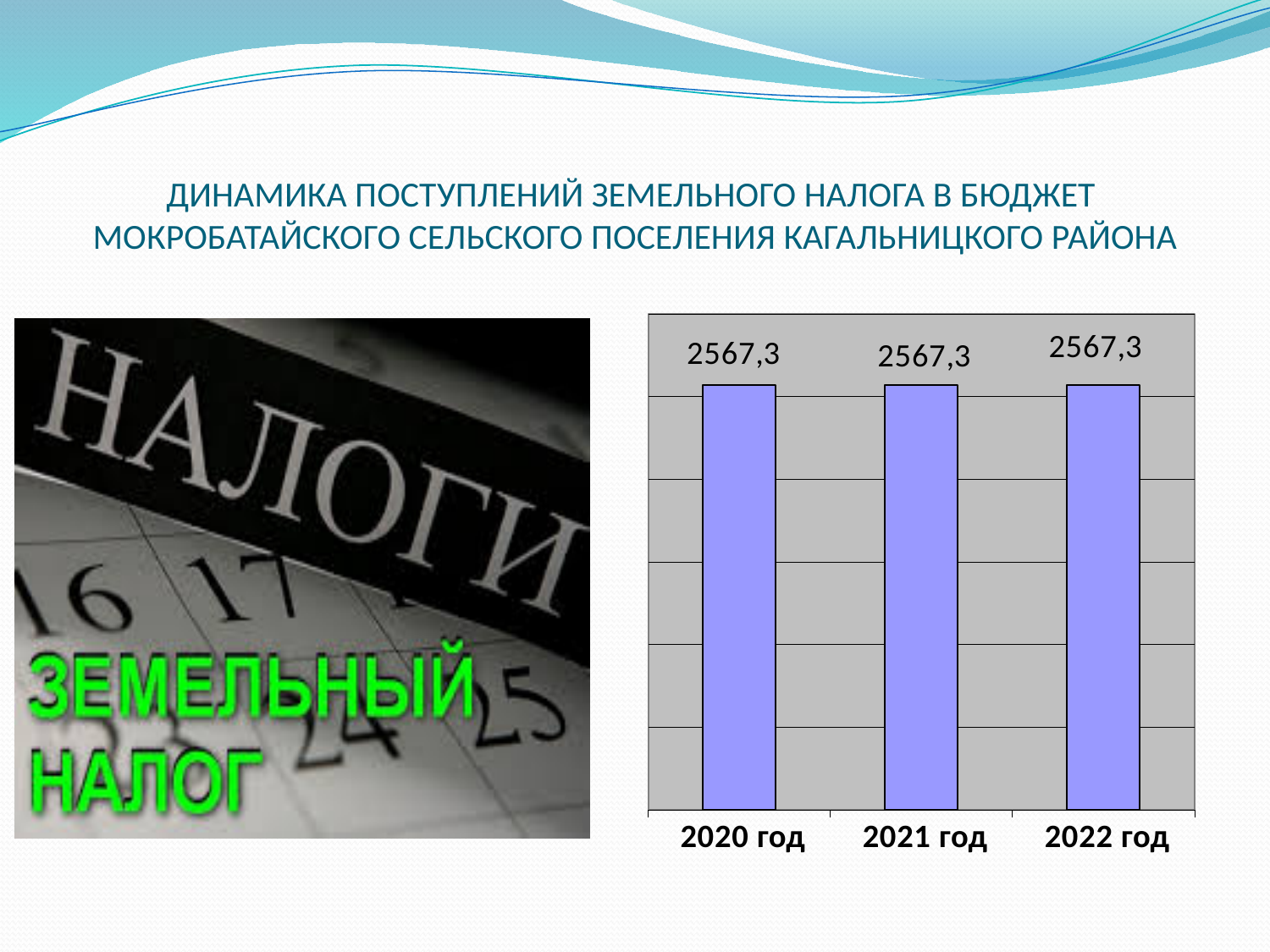
What kind of chart is shown on the slide? Bar chart What colour are the bars in the chart? Blue (light purple-blue) Do the values rise, fall, or stay the same from 2020 год to 2022 год? Stay the same What is the value for 2020 год? 2567,3 What is the value for 2022 год? 2567,3 What is the value for 2021 год? 2567,3 How many categories (years) are shown on the chart? 3 Is the value for 2021 год larger than, smaller than, or equal to the value for 2020 год? Equal Which year is the first category on the x axis? 2020 год What is the difference between the values for 2022 год and 2020 год? 0